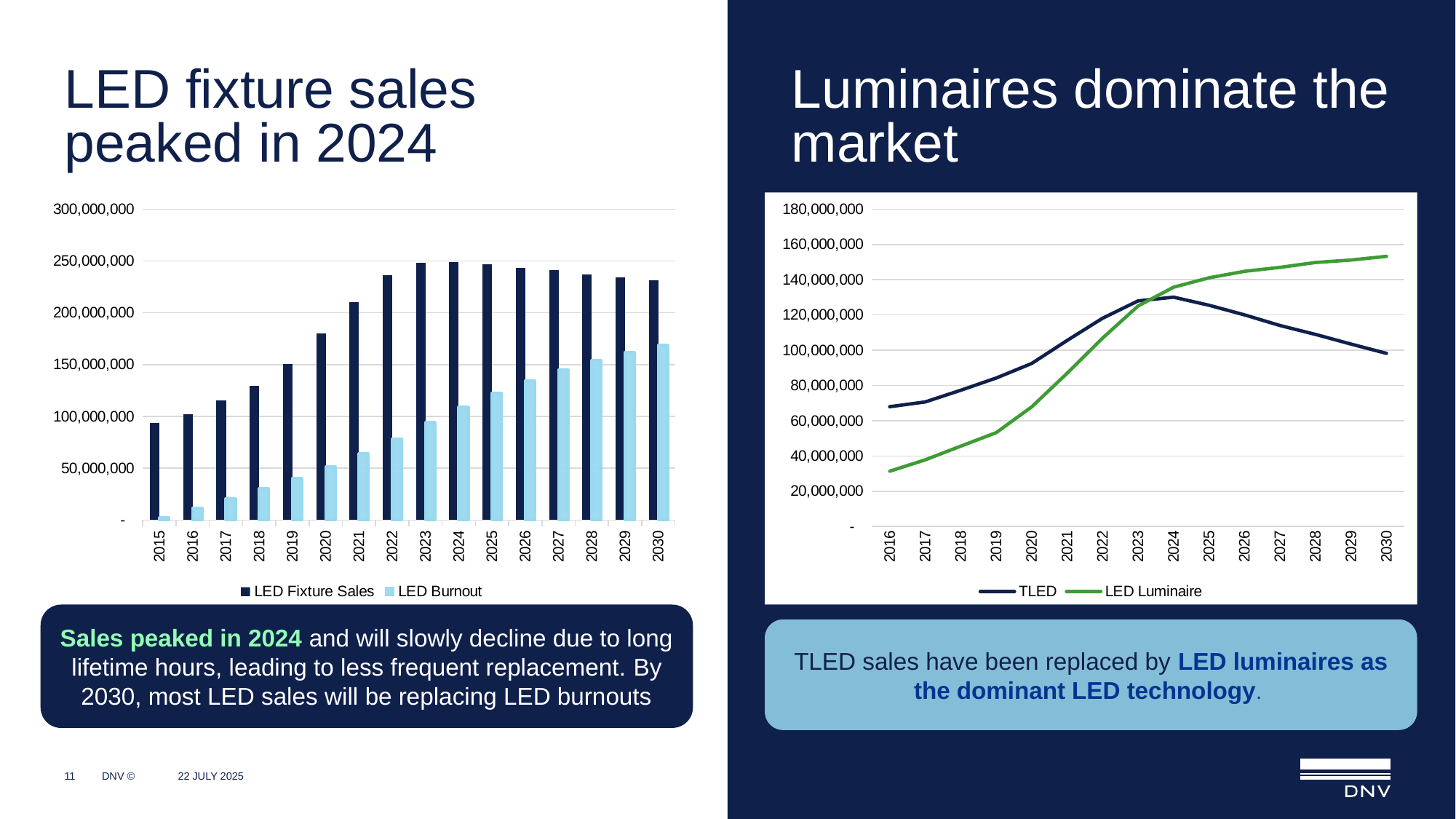
In the left bar chart, how many years are shown on the x axis? 16 In the right line chart, which year has the highest TLED value? 2024 In the left bar chart, how many series does the legend list? 2 What kind of chart is the right chart titled 'Luminaires dominate the market'? line chart In the left bar chart, which year has the highest LED Burnout value? 2030 In the right line chart, which series does the legend list? TLED and LED Luminaire In the right line chart, in 2030, which is larger: TLED or LED Luminaire? LED Luminaire In the left bar chart, which year has the lowest LED Fixture Sales value? 2015 In the left bar chart, is the LED Fixture Sales value for 2022 greater or less than 200,000,000? greater In the right line chart, how many years are shown on the x axis? 15 What kind of chart is the left chart titled 'LED fixture sales peaked in 2024'? bar chart In the right line chart, does the LED Luminaire series rise or fall from 2016 to 2030? rise